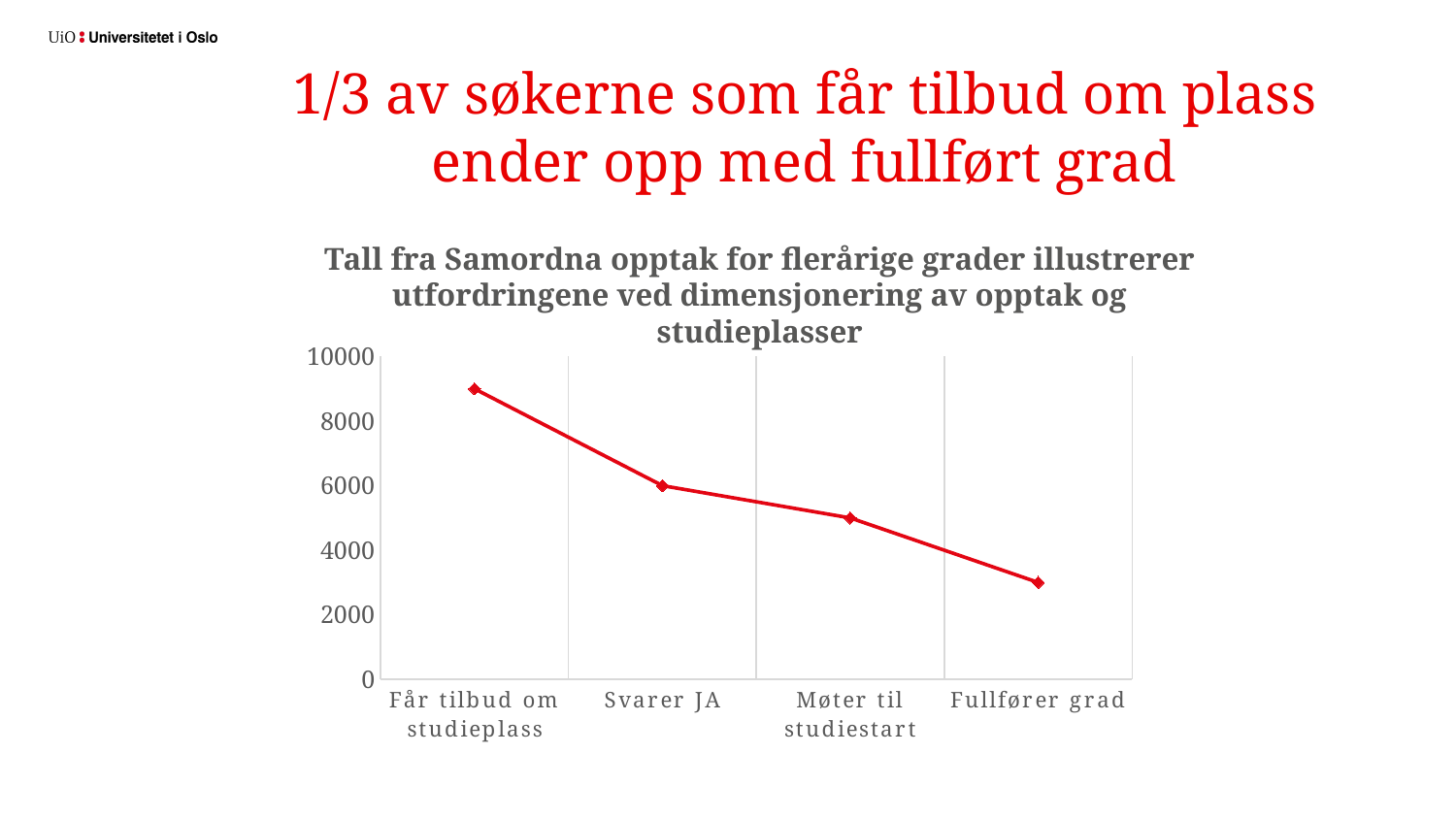
Is the value for Møter til studiestart greater or less than 4000? greater Which category has the highest value? Får tilbud om studieplass Is the value for Får tilbud om studieplass greater or less than 8000? greater Which category has the lowest value? Fullfører grad Do the values rise or fall from left to right along the x axis? fall What is the label of the third category on the x axis? Møter til studiestart What is the highest value shown on the y axis? 10000 How many categories are plotted along the x axis? 4 Is the value for Fullfører grad greater or less than 4000? less Which is larger, the value for Svarer JA or the value for Fullfører grad? Svarer JA What kind of chart is shown on the slide? line chart